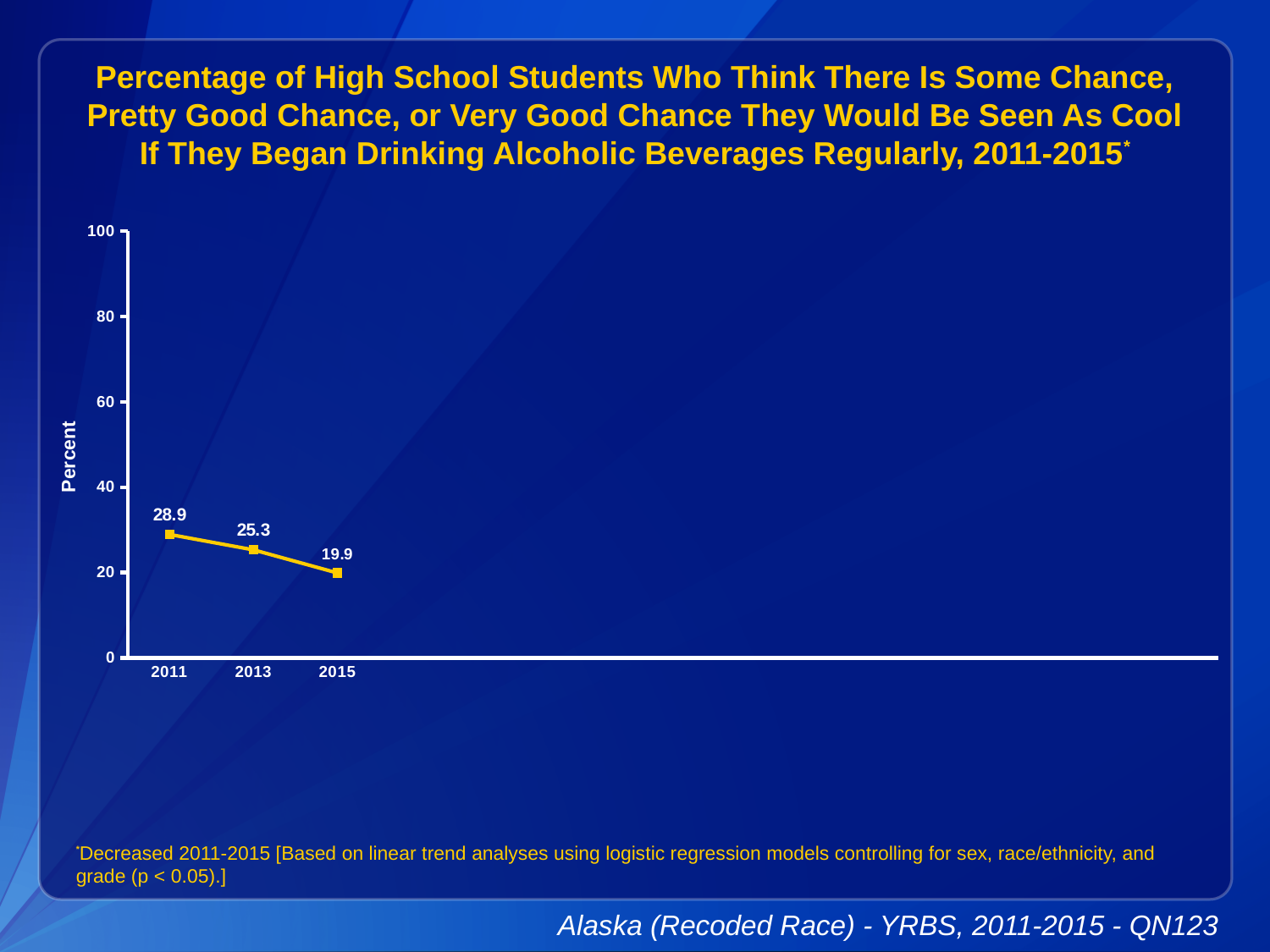
What is the difference between the values for 2013 and 2015? 5.4 What is the value for 2015? 19.9 Which is larger, the value for 2011 or the value for 2013? 2011 What is the difference between the values for 2011 and 2015? 9.0 Do the values rise or fall from 2011 to 2015? fall Is the value for 2015 greater or less than 20? less What is the value for 2013? 25.3 Which year has the lowest value? 2015 How many years are plotted on the chart? 3 What kind of chart is shown on the slide? line chart What is the value for 2011? 28.9 Which year has the highest value? 2011